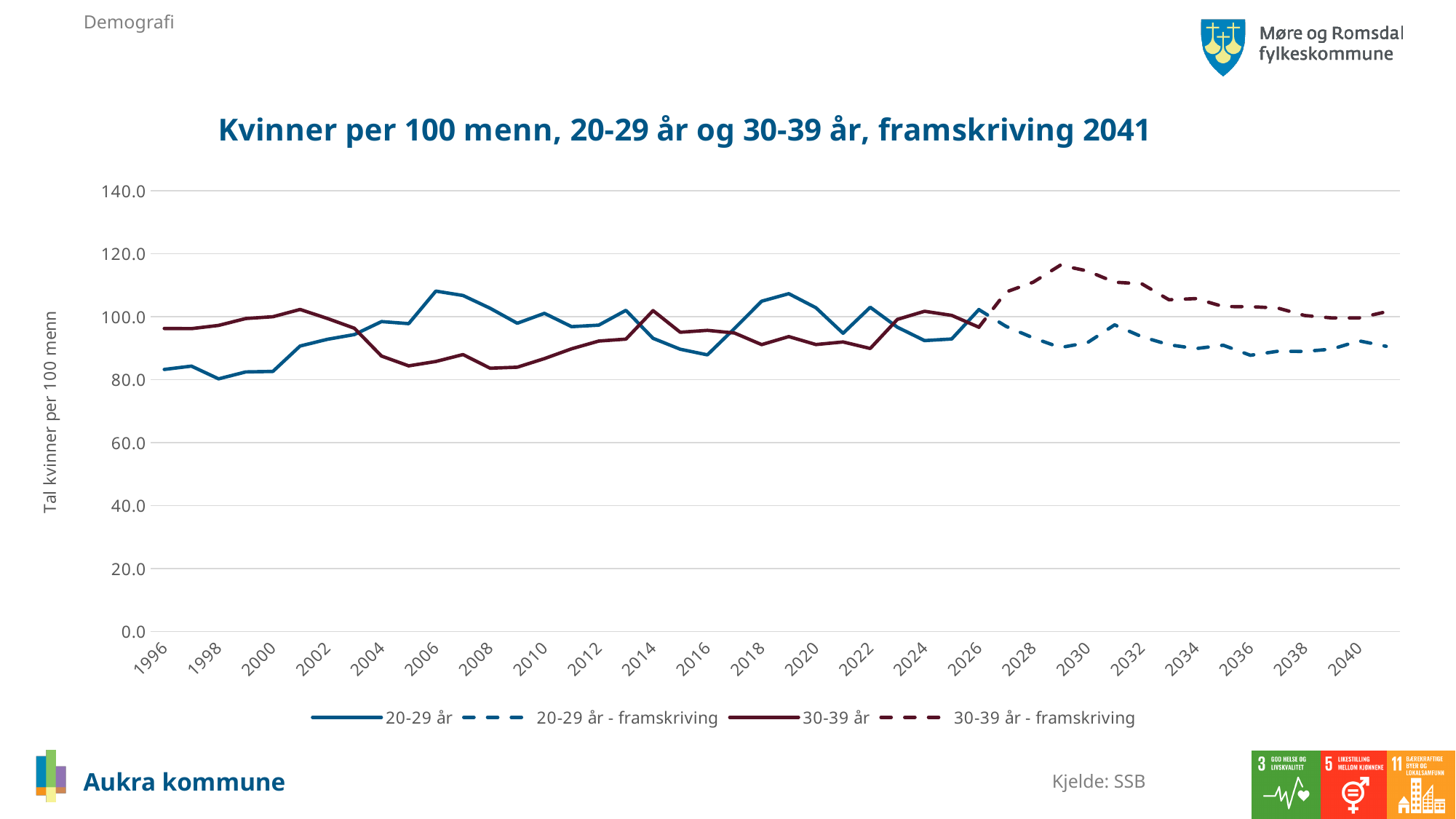
Is the value for 20-29 år in 1996 greater or less than 100? less Is the value for 30-39 år in 2008 greater or less than 100? less How many series does the legend list? 4 Which series reaches the highest value anywhere on the chart? 30-39 år - framskriving What kind of chart is shown on the slide? line chart Is the value for 20-29 år - framskriving in 2036 greater or less than 100? less In 2029, which is larger: 20-29 år - framskriving or 30-39 år - framskriving? 30-39 år - framskriving What is the title of the chart? Kvinner per 100 menn, 20-29 år og 30-39 år, framskriving 2041 What is the label on the y axis? Tal kvinner per 100 menn Does the 30-39 år - framskriving line generally rise or fall from 2029 to 2041? fall In 2006, which is larger: 20-29 år or 30-39 år? 20-29 år